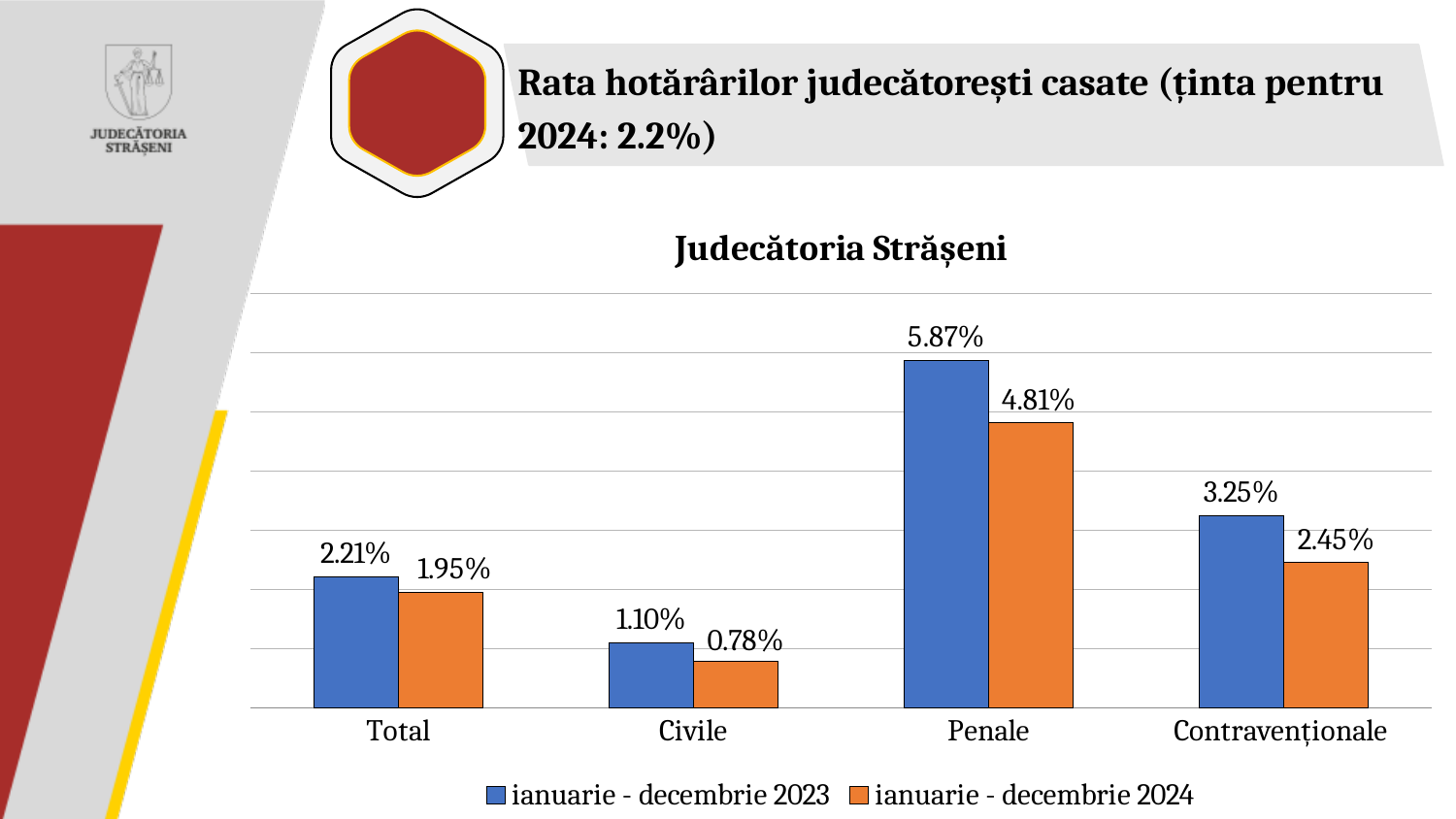
What is the value for Civile in the ianuarie - decembrie 2024 series? 0.78% What kind of chart is shown on the slide? Bar chart How many series does the legend list? 2 Which category has the lowest value in the ianuarie - decembrie 2023 series? Civile What is the value for Total in the ianuarie - decembrie 2024 series? 1.95% Which is larger for Contravenționale: the ianuarie - decembrie 2023 value or the ianuarie - decembrie 2024 value? ianuarie - decembrie 2023 What is the title of the chart? Judecătoria Strășeni What is the value for Penale in the ianuarie - decembrie 2023 series? 5.87% What is the difference between the 2023 and 2024 values for Penale? 1.06% How many categories are shown on the x axis? 4 Which category has the highest value in the ianuarie - decembrie 2024 series? Penale What is the value for Contravenționale in the ianuarie - decembrie 2023 series? 3.25%